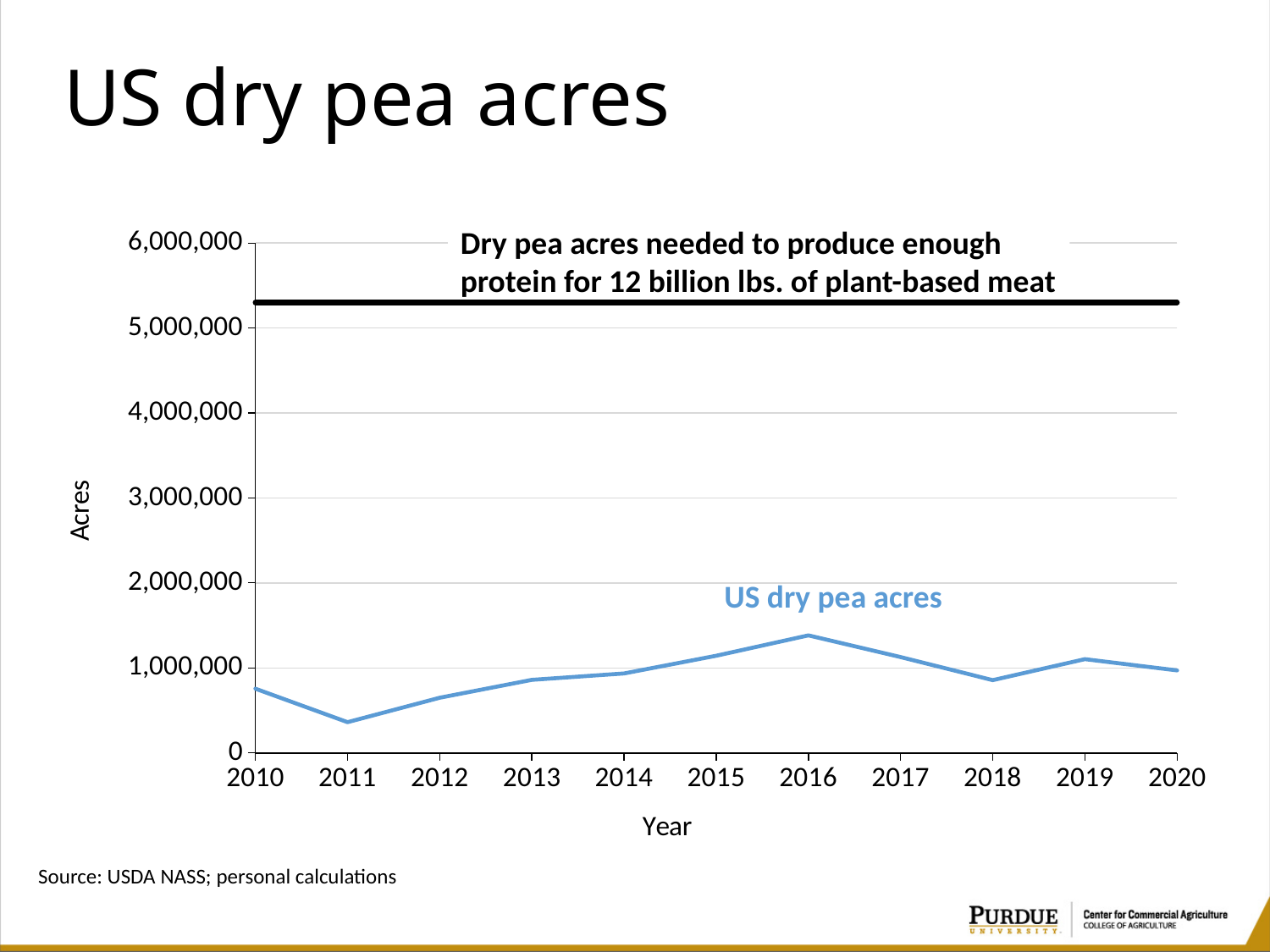
How many years are plotted along the x axis? 11 Is the value for US dry pea acres in 2016 greater or less than 1,000,000? greater Is the value for US dry pea acres in 2011 greater or less than 1,000,000? less Do US dry pea acres rise or fall from 2011 to 2016? rise In which year were US dry pea acres lowest? 2011 Which year had more US dry pea acres, 2017 or 2018? 2017 In which year were US dry pea acres highest? 2016 Is the line for dry pea acres needed to produce enough protein for 12 billion lbs. of plant-based meat greater or less than 5,000,000? greater Which year had more US dry pea acres, 2016 or 2011? 2016 What is the label on the y axis? Acres What kind of chart is shown on the slide? line chart